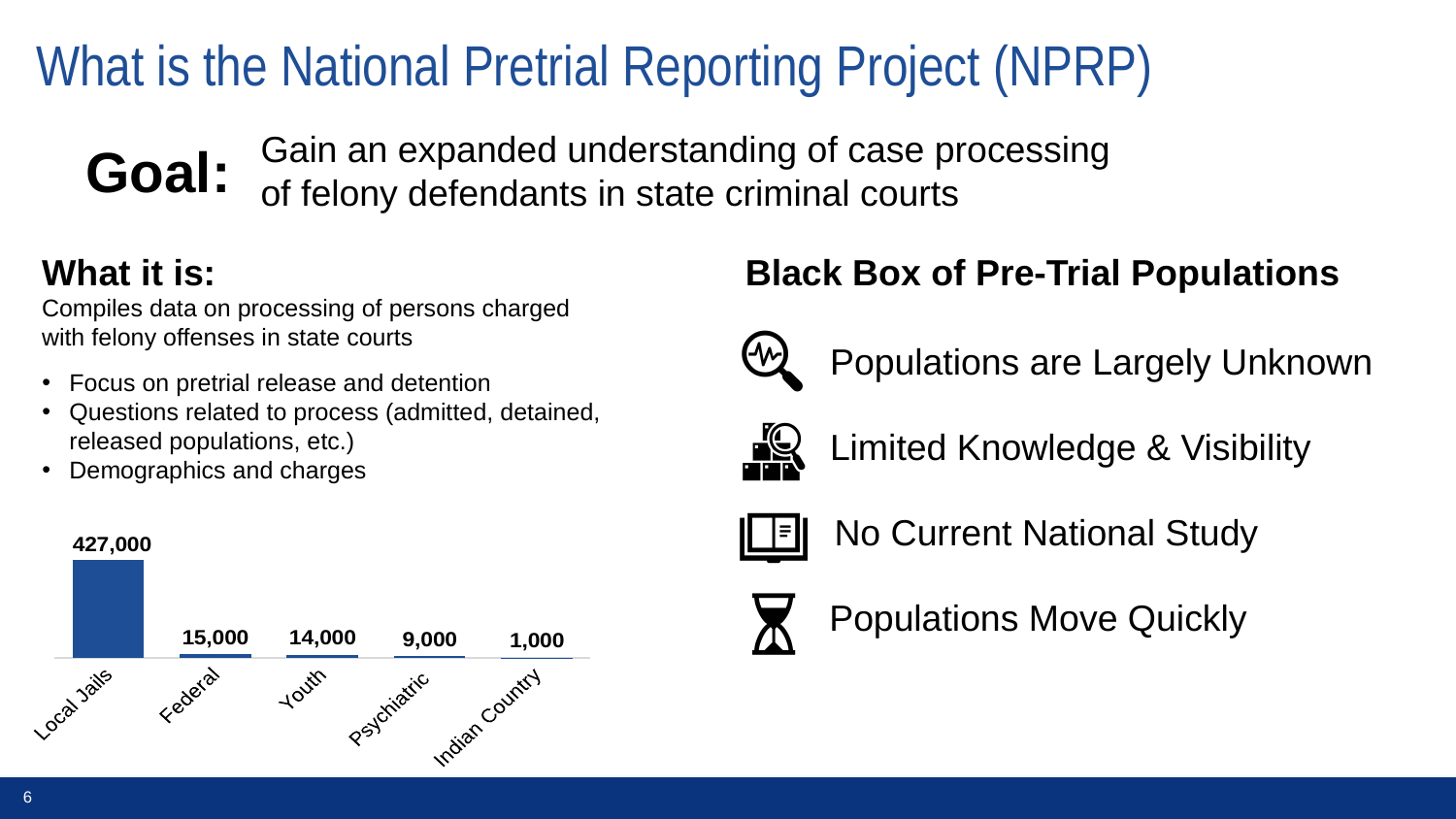
What is the value for Psychiatric in the bar chart? 9,000 Which category has the lowest value in the bar chart? Indian Country What is the value for Local Jails in the bar chart? 427,000 What is the value for Indian Country in the bar chart? 1,000 How many categories are shown in the bar chart? 5 What is the value for Federal in the bar chart? 15,000 What kind of chart is shown on the slide? Bar chart Which category has the highest value in the bar chart? Local Jails What is the difference between the values for Local Jails and Federal? 412,000 What is the value for Youth in the bar chart? 14,000 What is the difference between the values for Psychiatric and Indian Country? 8,000 Which is larger, the value for Federal or the value for Psychiatric? Federal